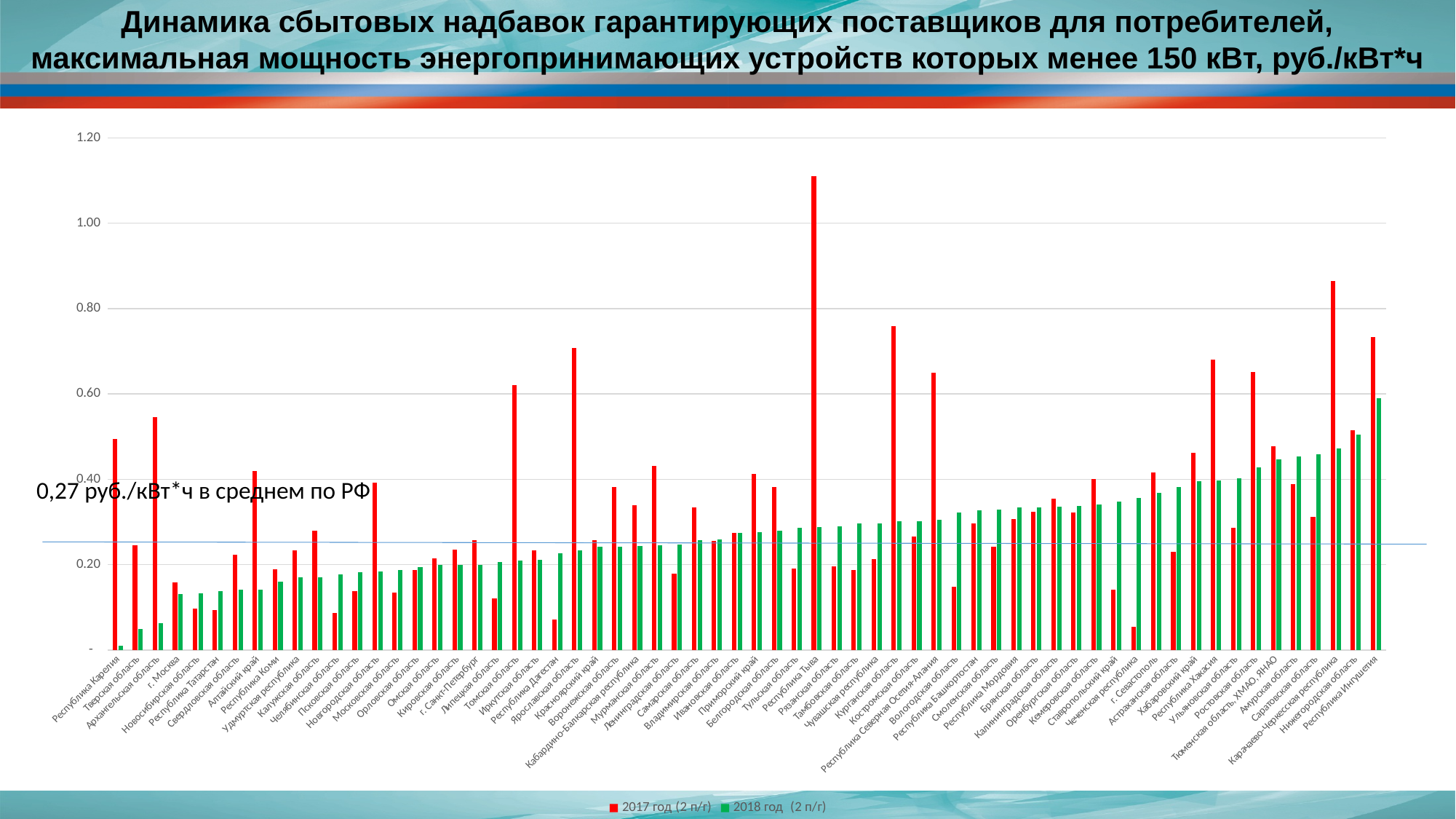
What average value for the Russian Federation is annotated on the chart? 0,27 руб./кВт*ч Is the 2017 год (2 п/г) value for Республика Тыва greater or less than 1.00? greater Do the 2018 год (2 п/г) values generally rise or fall from left to right along the x axis? rise Is the 2017 год (2 п/г) value for Костромская область greater or less than 0.60? less Is the 2018 год (2 п/г) value for Республика Ингушетия greater or less than 0.40? greater For Республика Тыва, which series has the larger value, 2017 год (2 п/г) or 2018 год (2 п/г)? 2017 год (2 п/г) What are the two series named in the legend? 2017 год (2 п/г) and 2018 год (2 п/г) Which region has the highest value for 2018 год (2 п/г)? Республика Ингушетия How many series does the legend list? 2 What kind of chart is shown on the slide? bar chart Which region has the highest value for 2017 год (2 п/г)? Республика Тыва